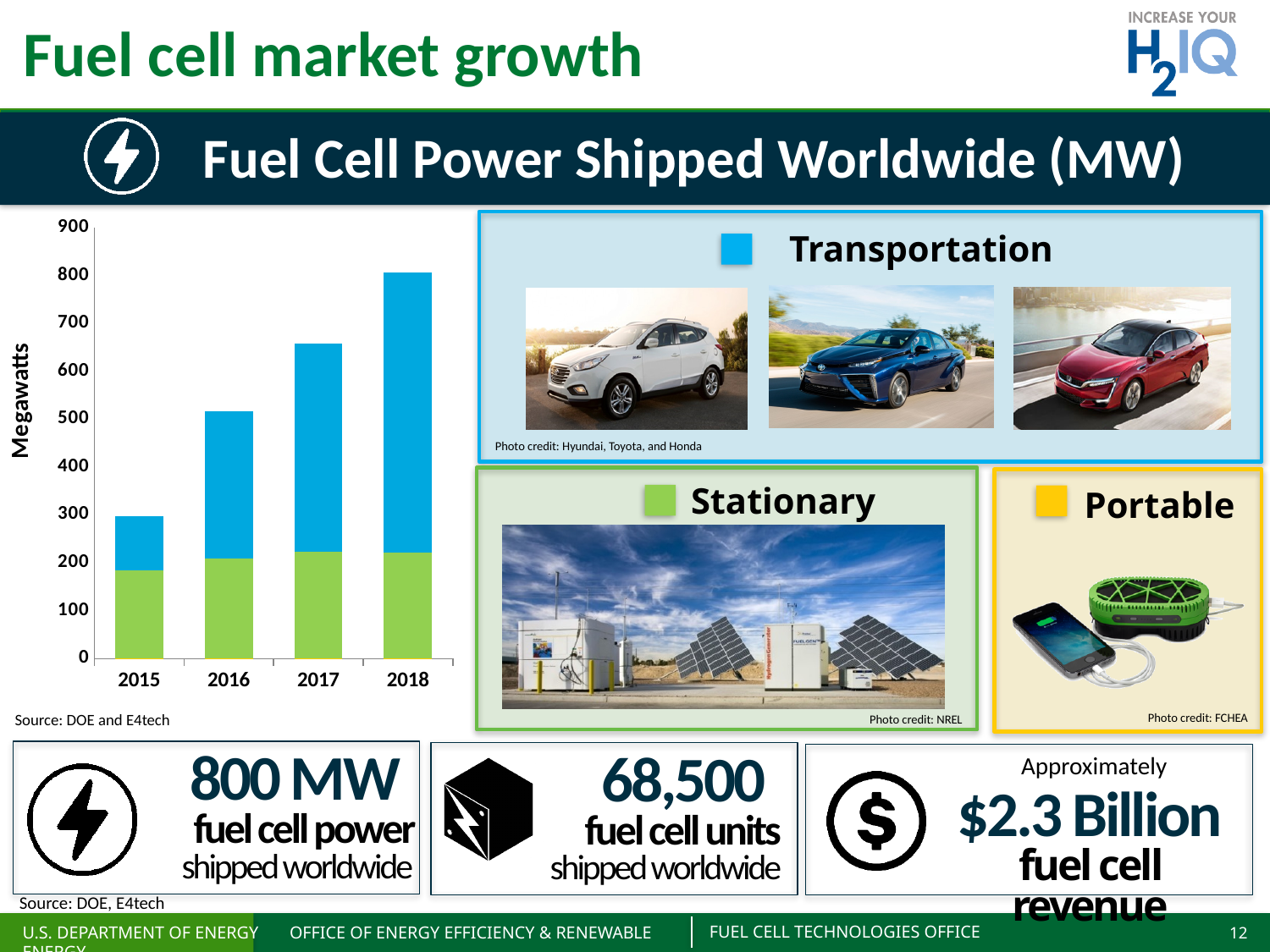
Which is larger, the Transportation segment in 2017 or in 2016? 2017 Which year has the highest total fuel cell power shipped? 2018 How many years are shown on the x axis of the chart? 4 Is the total value for 2017 greater or less than 700? less What is the label on the chart's y axis? Megawatts How many series (segment categories) does the chart's legend list? 3 Do the total bar heights rise or fall from 2015 to 2018? Rise Is the total value for 2018 greater or less than 700? greater Is the Stationary segment for 2015 greater or less than 200? less What kind of chart is shown on the slide? Stacked bar chart Which year has the lowest total fuel cell power shipped? 2015